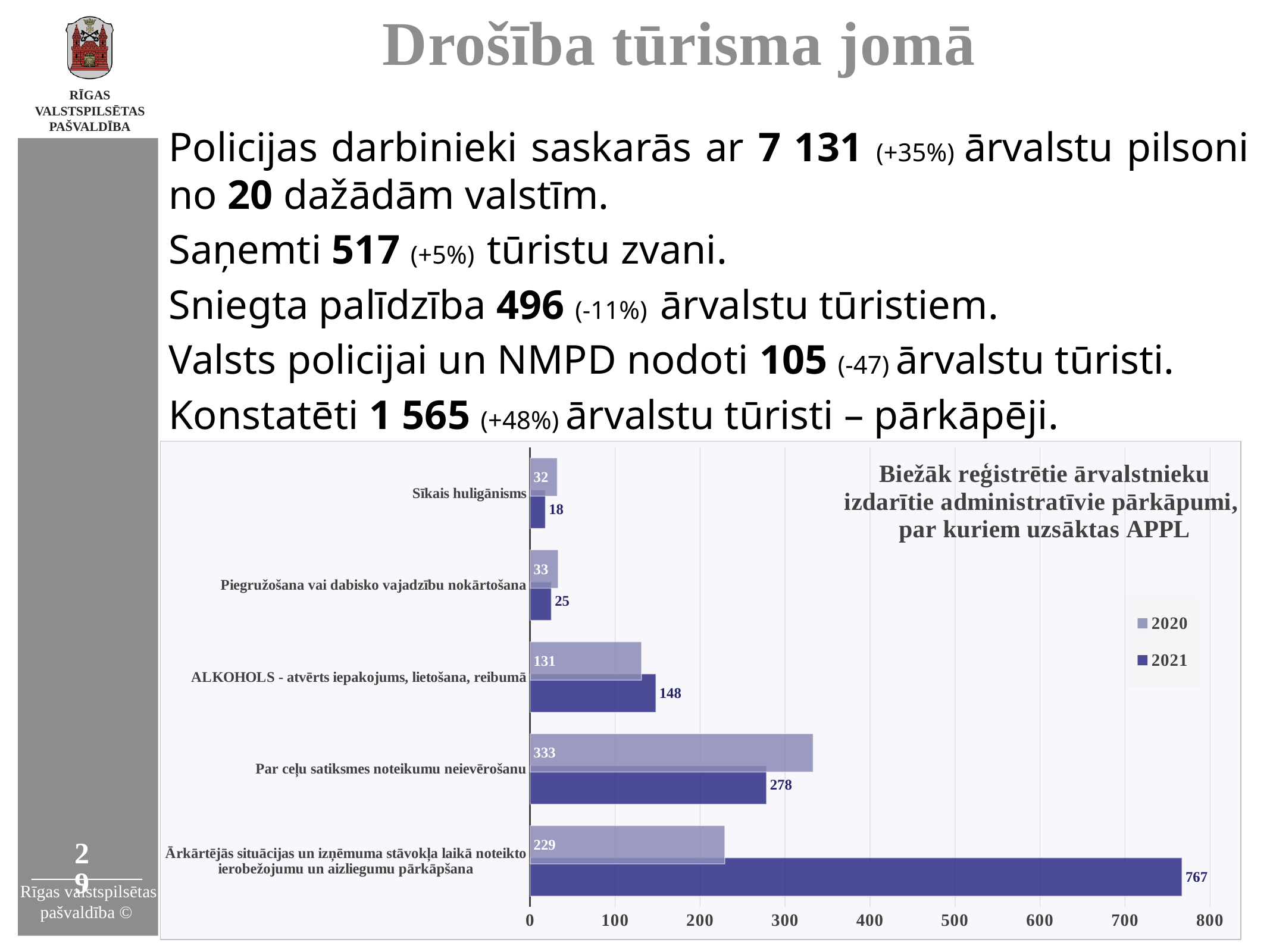
How many series does the legend list? 2 Which category has the highest 2021 value? Ārkārtējās situācijas un izņēmuma stāvokļa laikā noteikto ierobežojumu un aizliegumu pārkāpšana What is the difference between the 2021 and 2020 values for "Ārkārtējās situācijas un izņēmuma stāvokļa laikā noteikto ierobežojumu un aizliegumu pārkāpšana"? 538 What is the 2020 value for "Piegružošana vai dabisko vajadzību nokārtošana"? 33 How many categories are shown in the chart? 5 Which category has the lowest 2020 value? Sīkais huligānisms What kind of chart is shown on the slide? Bar chart For "ALKOHOLS - atvērts iepakojums, lietošana, reibumā", which year has the larger value, 2020 or 2021? 2021 For "Par ceļu satiksmes noteikumu neievērošanu", which year has the larger value, 2020 or 2021? 2020 What is the 2020 value for "ALKOHOLS - atvērts iepakojums, lietošana, reibumā"? 131 What is the 2021 value for "Sīkais huligānisms"? 18 What is the 2021 value for "Par ceļu satiksmes noteikumu neievērošanu"? 278